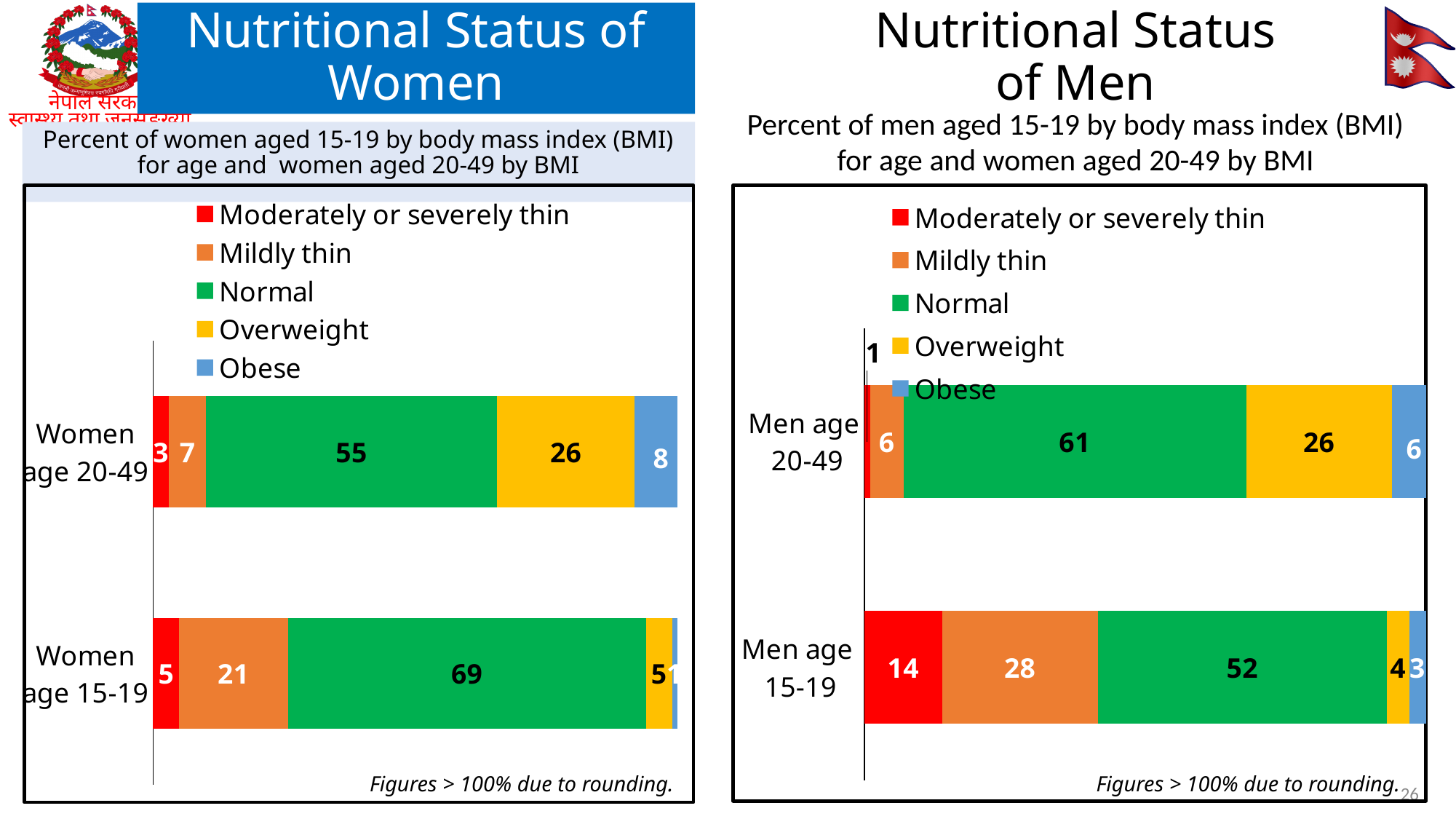
In the Nutritional Status of Women chart, which BMI category has the largest share among women age 15-19? Normal In the Nutritional Status of Men chart, what is the total of the labelled values for men age 15-19? 101 In the Nutritional Status of Men chart, which group has a higher Normal percentage, men age 20-49 or men age 15-19? Men age 20-49 In the Nutritional Status of Women chart, what is the difference between the Overweight percentages for women age 20-49 and women age 15-19? 21 In the Nutritional Status of Men chart, what percent of men age 15-19 are Moderately or severely thin? 14 What kind of chart is the Nutritional Status of Men chart? Stacked bar chart How many age groups are shown in the Nutritional Status of Women chart? 2 How many series does the legend of the Nutritional Status of Men chart list? 5 In the Nutritional Status of Women chart, what percent of women age 15-19 are Mildly thin? 21 In the Nutritional Status of Men chart, what percent of men age 20-49 are Overweight? 26 In the Nutritional Status of Men chart, which BMI category has the smallest share among men age 20-49? Moderately or severely thin In the Nutritional Status of Women chart, what percent of women age 20-49 are Normal? 55